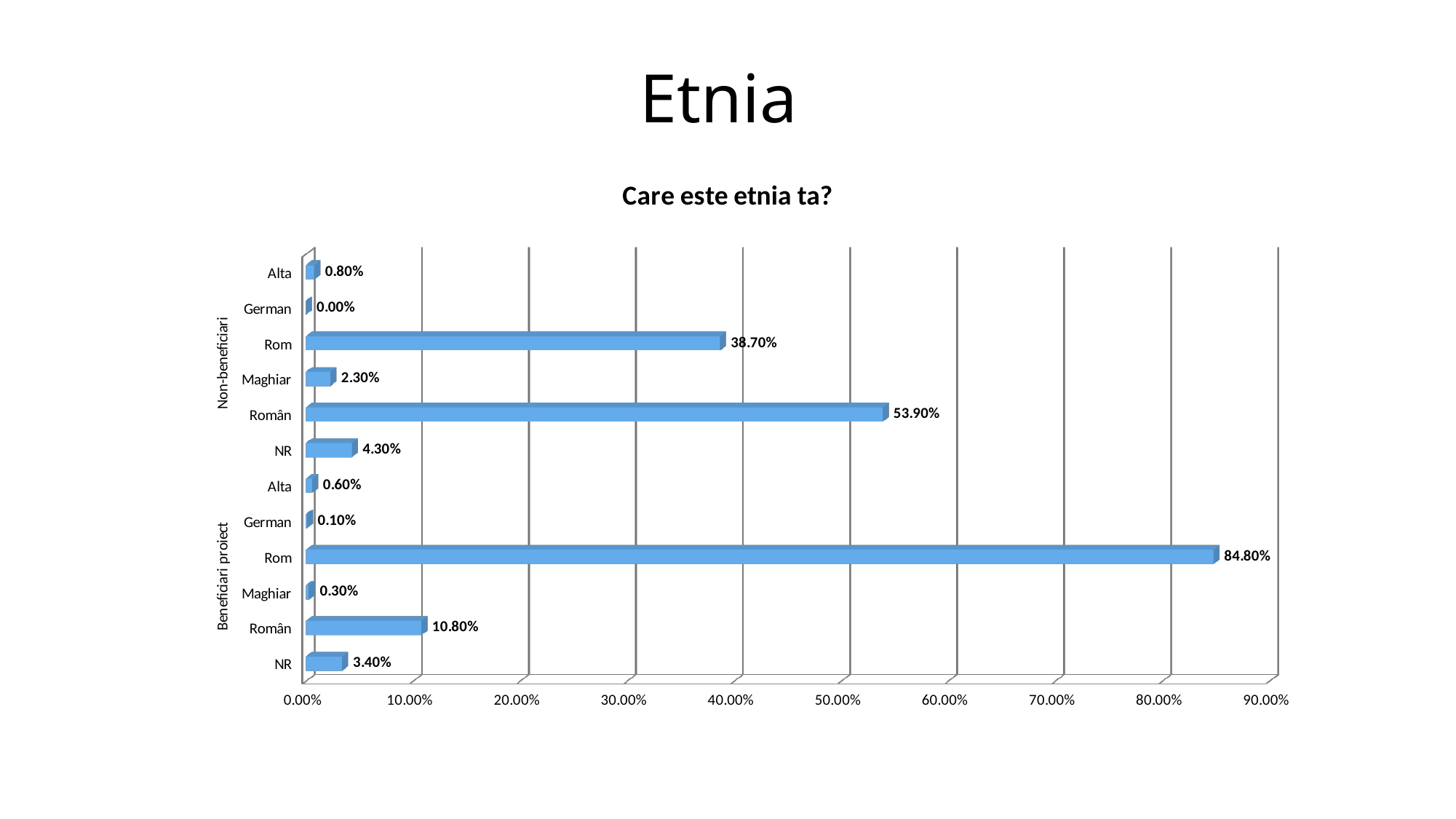
How many bars are plotted on the chart? 12 Which is larger: Român for Non-beneficiari or Rom for Non-beneficiari? Român for Non-beneficiari Which category has the lowest value on the chart? German (Non-beneficiari) What is the title of the chart? Care este etnia ta? What is the value for Rom in the Beneficiari proiect group? 84.80% Is the value for Român in the Beneficiari proiect group greater or less than 20.00%? less What kind of chart is shown? Bar chart Which category has the highest value on the chart? Rom (Beneficiari proiect) What is the difference between the Rom values for Beneficiari proiect and Non-beneficiari? 46.10% What is the value for Maghiar in the Beneficiari proiect group? 0.30% What is the value for Român in the Non-beneficiari group? 53.90% What is the value for NR in the Non-beneficiari group? 4.30%